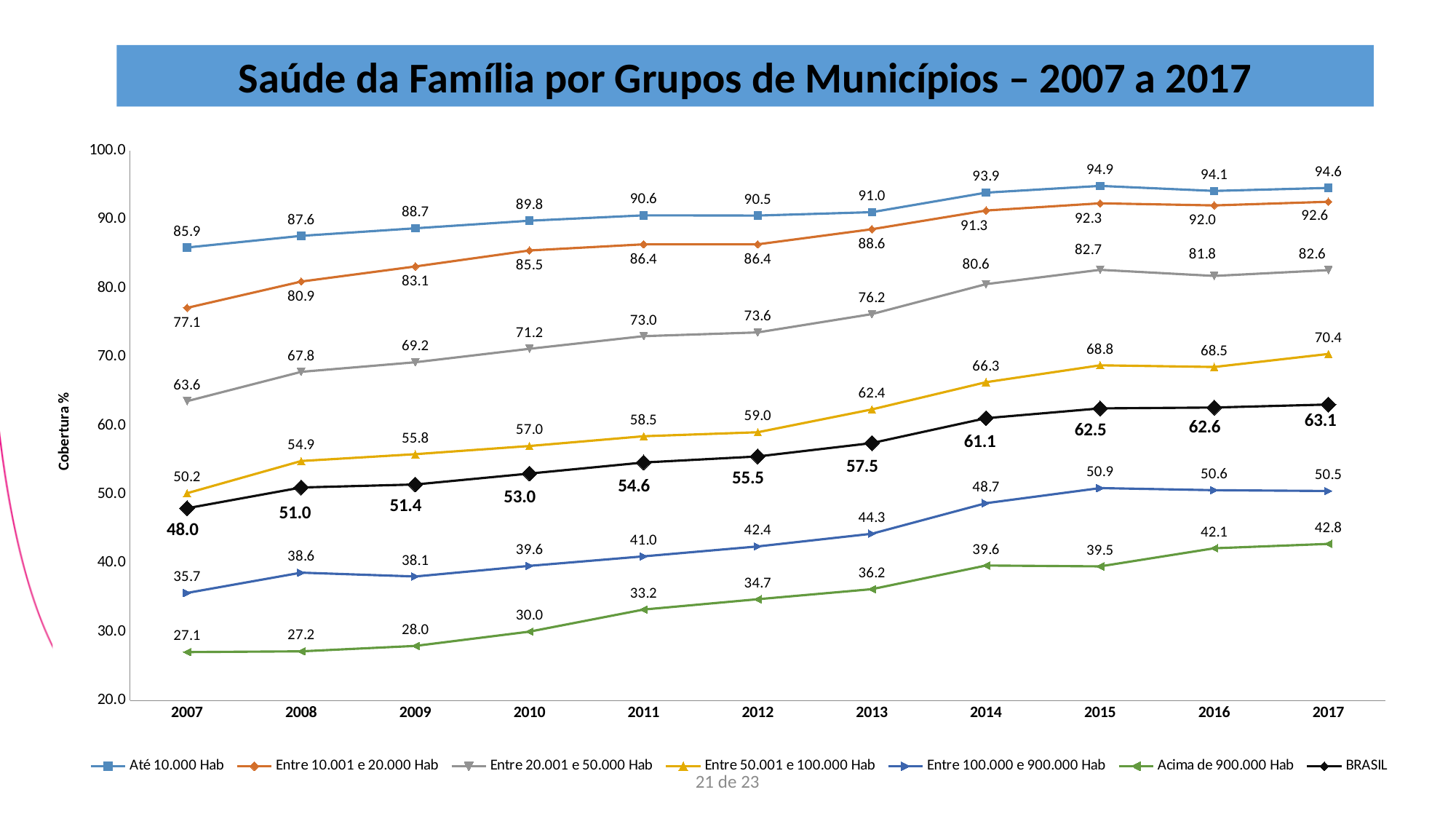
How many years are shown on the x axis? 11 What is the value for Entre 50.001 e 100.000 Hab in 2013? 62.4 In 2015, which is larger: Entre 100.000 e 900.000 Hab or Acima de 900.000 Hab? Entre 100.000 e 900.000 Hab Does the Entre 20.001 e 50.000 Hab series rise or fall from 2007 to 2017? Rise By how much did the BRASIL value increase from 2007 to 2017? 15.1 What kind of chart is shown on the slide? Line chart What is the value for Acima de 900.000 Hab in 2010? 30.0 In which year does the Até 10.000 Hab series reach its highest value? 2015 What is the value for Até 10.000 Hab in 2007? 85.9 How many series does the legend list? 7 In which year is the BRASIL series at its lowest value? 2007 What is the value for BRASIL in 2017? 63.1